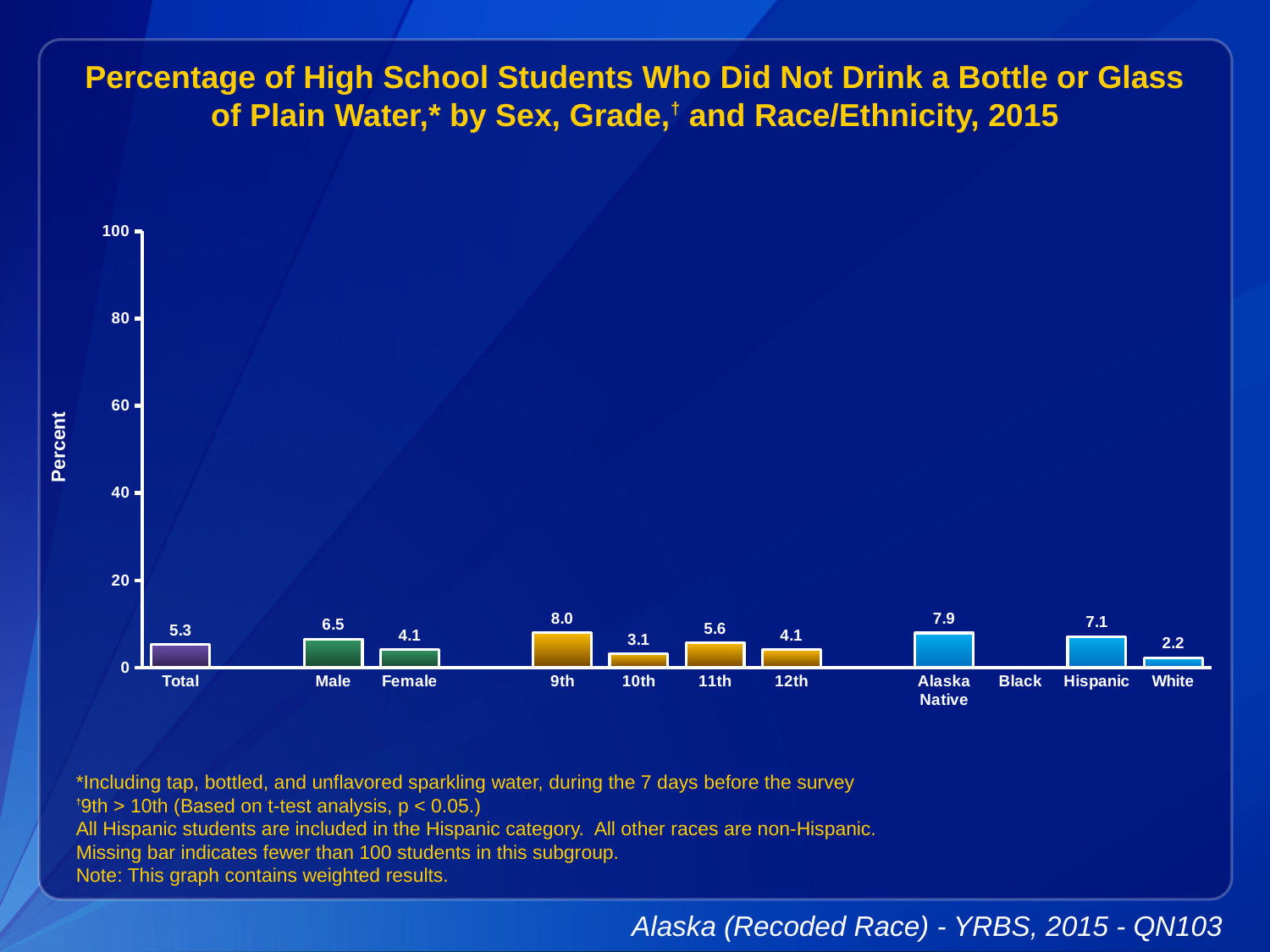
Which is larger, the value for Hispanic or the value for White? Hispanic What is the value for Total? 5.3 What is the value for 10th grade? 3.1 Is the value for 11th grade greater or less than 20? less What kind of chart is shown on the slide? bar chart Which category has no bar shown on the chart? Black Which category has the lowest value among those with a bar shown? White What is the difference between the 9th and 10th grade values? 4.9 What is the value for Alaska Native? 7.9 What is the value for Female? 4.1 Which category has the highest value? 9th What is the difference between the Male and Female values? 2.4